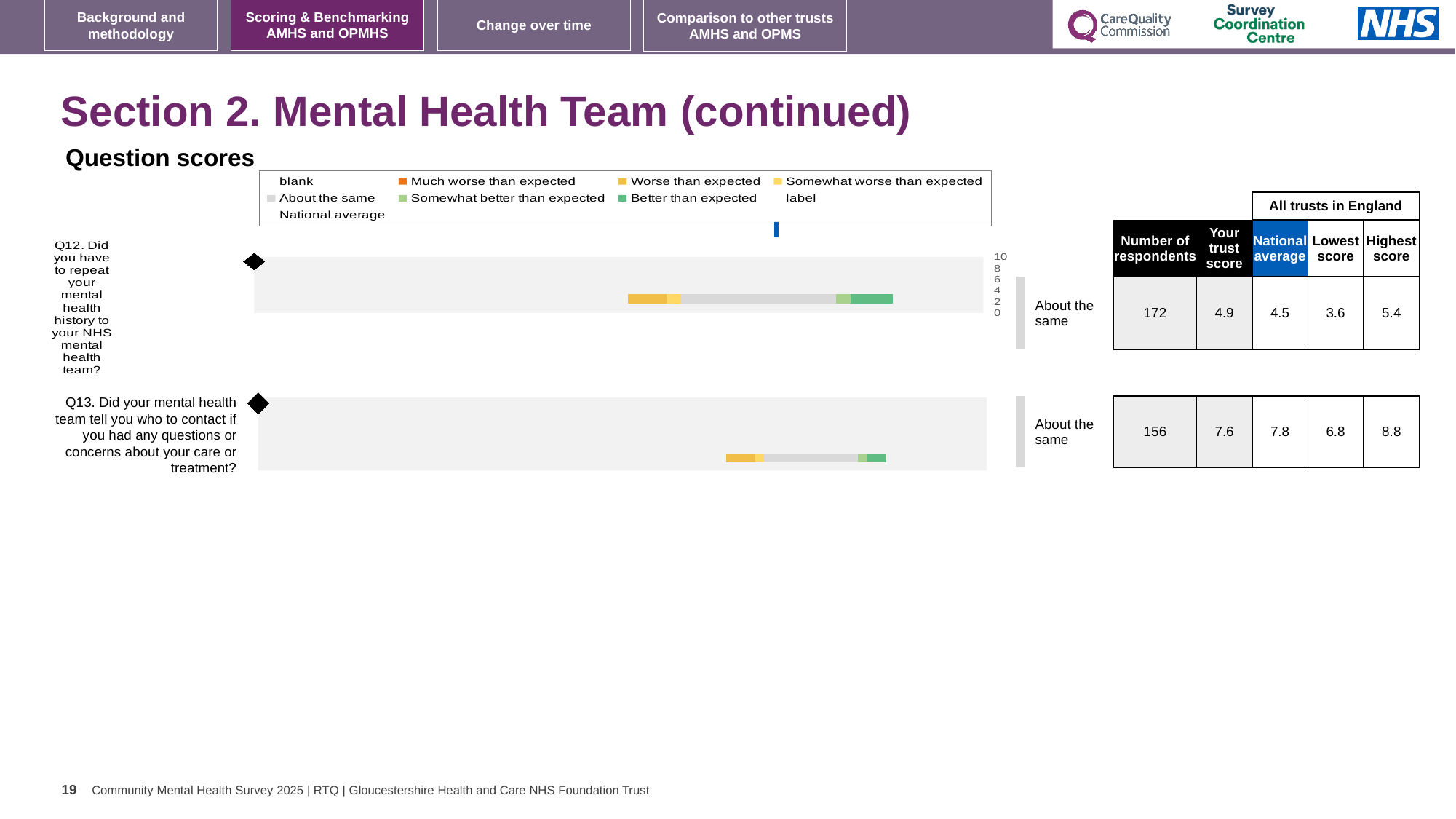
How many questions are plotted in the question scores chart? 2 What is the highest score across all trusts in England for Q13? 8.8 What is the national average shown for Q13 (told who to contact)? 7.8 What kind of chart is used to show the question scores for Q12 and Q13? bar chart What is the trust score shown for Q12 (repeating mental health history)? 4.9 How many respondents are shown for Q12? 172 What is the difference between the highest score and the lowest score for Q12? 1.8 For Q13, which is larger: the trust score or the national average? the national average For Q12, which is larger: the trust score or the national average? the trust score Which legend entry is shown in dark green? Better than expected How many more respondents answered Q12 than Q13? 16 What benchmark category is shown for Q12? About the same